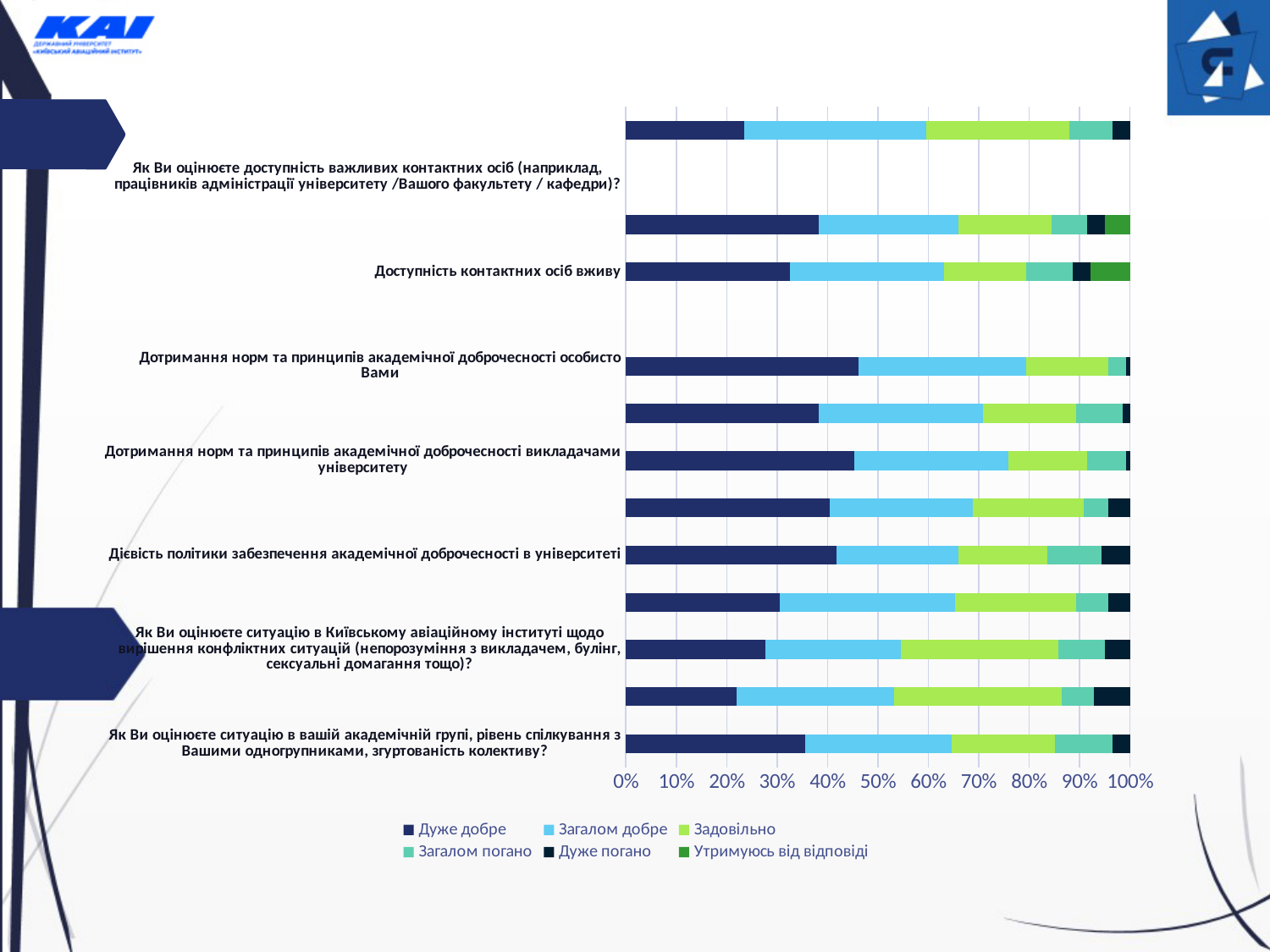
What kind of chart is shown on the slide? Stacked bar chart Is the 'Дуже добре' value for 'Як Ви оцінюєте ситуацію в Київському авіаційному інституті щодо вирішення конфліктних ситуацій' greater or less than 30%? less Is the 'Дуже добре' value for 'Як Ви оцінюєте ситуацію в вашій академічній групі, рівень спілкування з Вашими одногрупниками, згуртованість колективу?' greater or less than 40%? less Is the 'Дуже добре' value for 'Дотримання норм та принципів академічної доброчесності викладачами університету' greater or less than 40%? greater How many series does the legend list? 6 Which has a larger 'Дуже добре' share: 'Дотримання норм та принципів академічної доброчесності особисто Вами' or 'Як Ви оцінюєте ситуацію в Київському авіаційному інституті щодо вирішення конфліктних ситуацій'? Дотримання норм та принципів академічної доброчесності особисто Вами What is the highest value shown on the x axis? 100% Which series is shown in dark green in the legend? Утримуюсь від відповіді Which has a larger 'Дуже добре' share: 'Дотримання норм та принципів академічної доброчесності викладачами університету' or 'Доступність контактних осіб вживу'? Дотримання норм та принципів академічної доброчесності викладачами університету